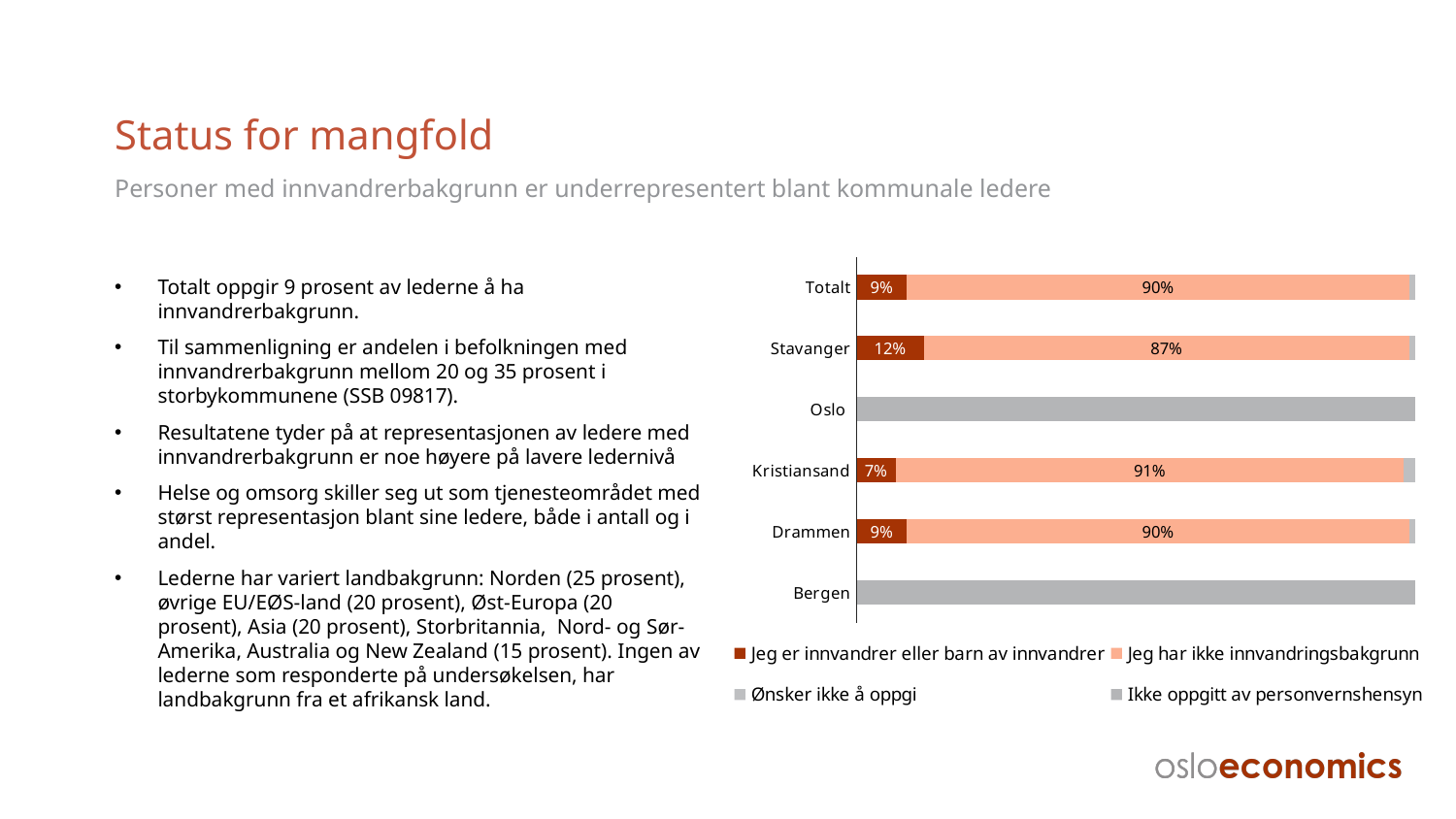
How many categories are shown on the vertical axis of the chart? 6 Which two categories in the chart have no percentage labels and are shown entirely in grey? Oslo and Bergen What is the value for "Jeg er innvandrer eller barn av innvandrer" in the Totalt bar? 9% What percentage of leaders in Kristiansand answered "Jeg har ikke innvandringsbakgrunn"? 91% What is the difference in percentage points between Stavanger's and Kristiansand's share of leaders who are immigrants or children of immigrants? 5 percentage points What type of chart is shown on the slide? Stacked bar chart Which has a larger share of leaders without immigrant background, Stavanger or Kristiansand? Kristiansand Among the municipalities with printed values, which has the lowest share of leaders who are immigrants or children of immigrants? Kristiansand How many series does the chart legend list? 4 What percentage of leaders in Drammen answered "Jeg har ikke innvandringsbakgrunn"? 90% Among the municipalities with printed values, which has the highest share of leaders who are immigrants or children of immigrants? Stavanger What percentage of leaders in Stavanger answered "Jeg er innvandrer eller barn av innvandrer"? 12%